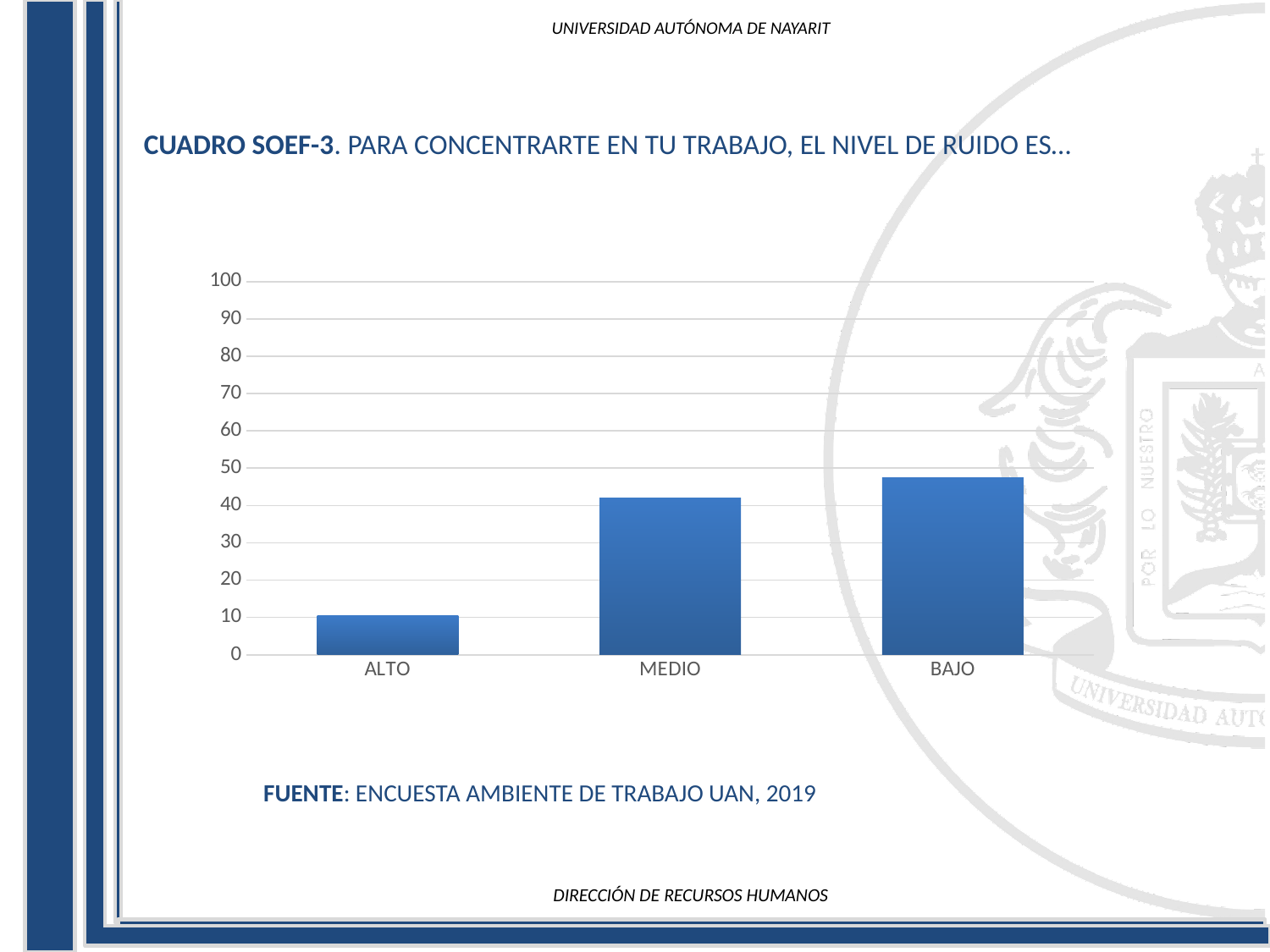
Do the bar values rise or fall moving from ALTO to BAJO along the x axis? rise Which category has the highest bar in the chart? BAJO Is the value for MEDIO greater or less than 30? greater What kind of chart is shown on the slide? bar chart What source is cited below the chart? ENCUESTA AMBIENTE DE TRABAJO UAN, 2019 Is the value for ALTO greater or less than 20? less Which is larger, the value for MEDIO or the value for BAJO? BAJO Which category has the lowest bar in the chart? ALTO Is the value for MEDIO greater or less than 50? less Which is larger, the value for ALTO or the value for MEDIO? MEDIO How many categories are shown on the x axis of the chart? 3